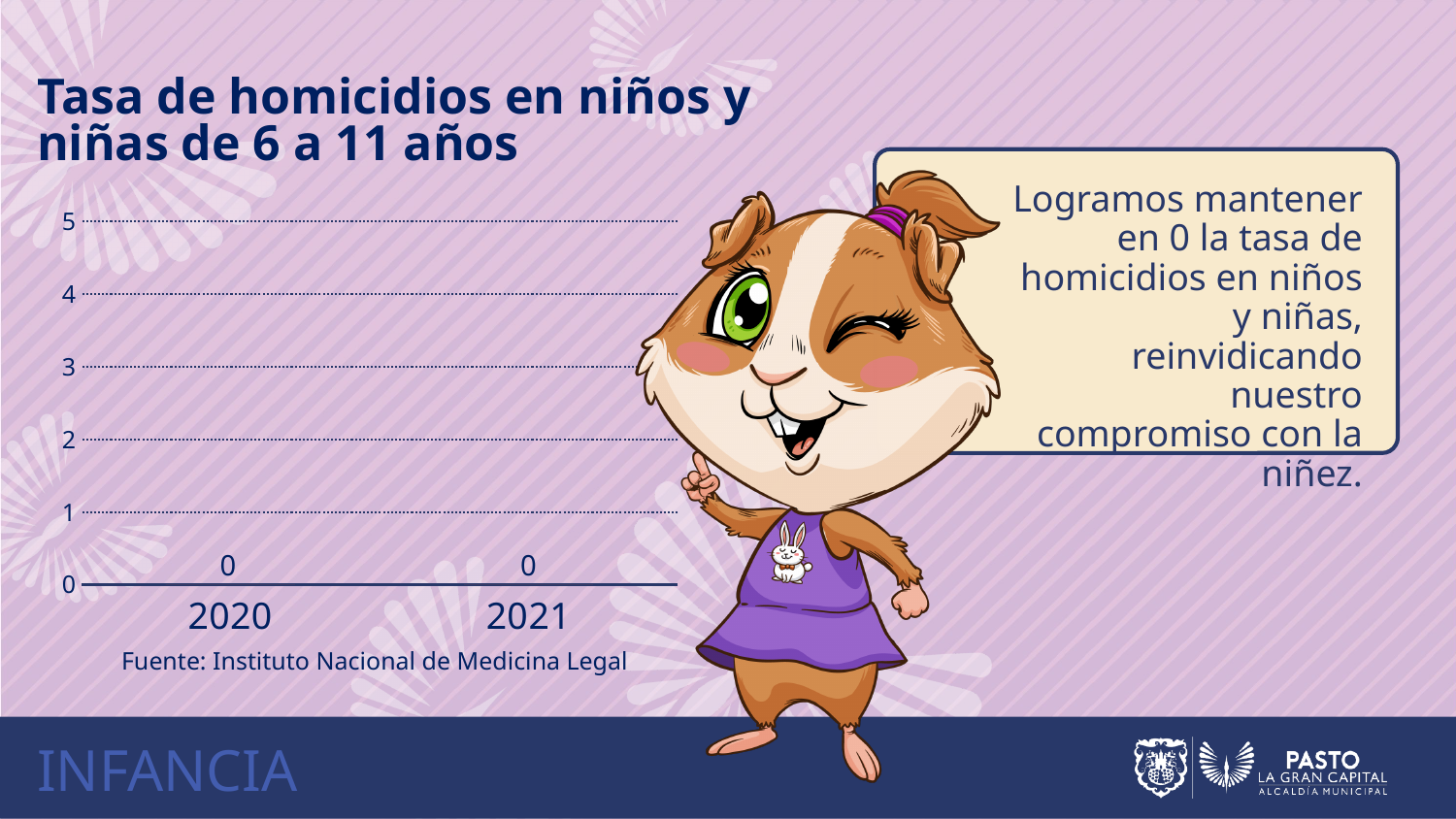
Is the value for 2020 greater or less than 1? less What is the total of the values for 2020 and 2021? 0 What is the highest value shown on the y axis? 5 What is the difference between the values for 2020 and 2021? 0 Do the values rise, fall or stay the same from 2020 to 2021? stay the same Is the value for 2021 greater or less than 1? less What is the value for 2021? 0 What is the value for 2020? 0 What is the title of the chart? Tasa de homicidios en niños y niñas de 6 a 11 años How many categories are shown on the x axis? 2